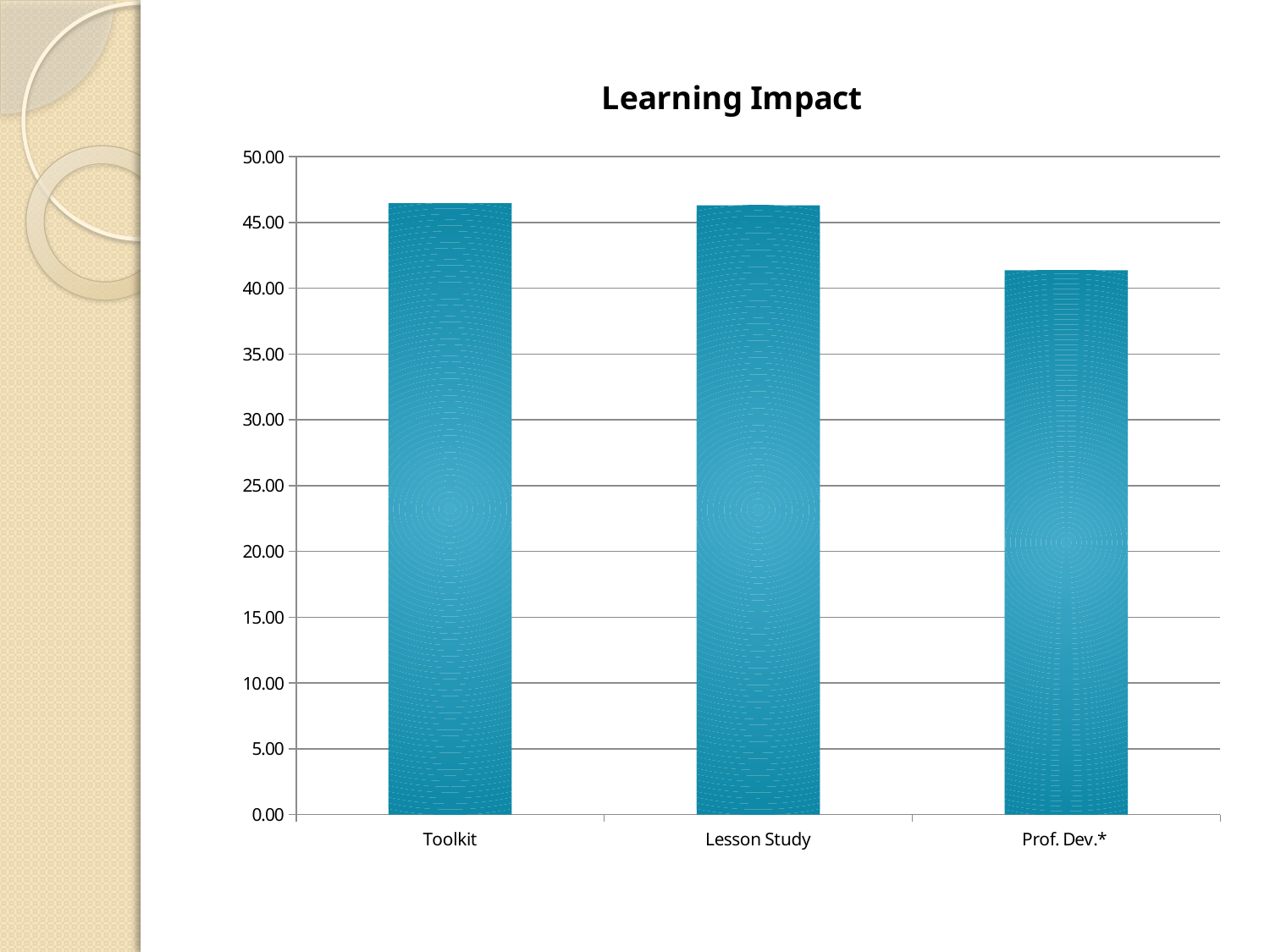
Which category has the lowest value? Prof. Dev.* Is the value for Toolkit greater or less than 45.00? greater Is the value for Prof. Dev.* greater or less than 40.00? greater Is the value for Prof. Dev.* greater or less than 45.00? less What is the title of the chart? Learning Impact What is the maximum value shown on the vertical axis? 50.00 What kind of chart is shown on the slide? Bar chart Which is larger, the value for Lesson Study or the value for Prof. Dev.*? Lesson Study How many categories are plotted in the chart? 3 Which is larger, the value for Toolkit or the value for Prof. Dev.*? Toolkit